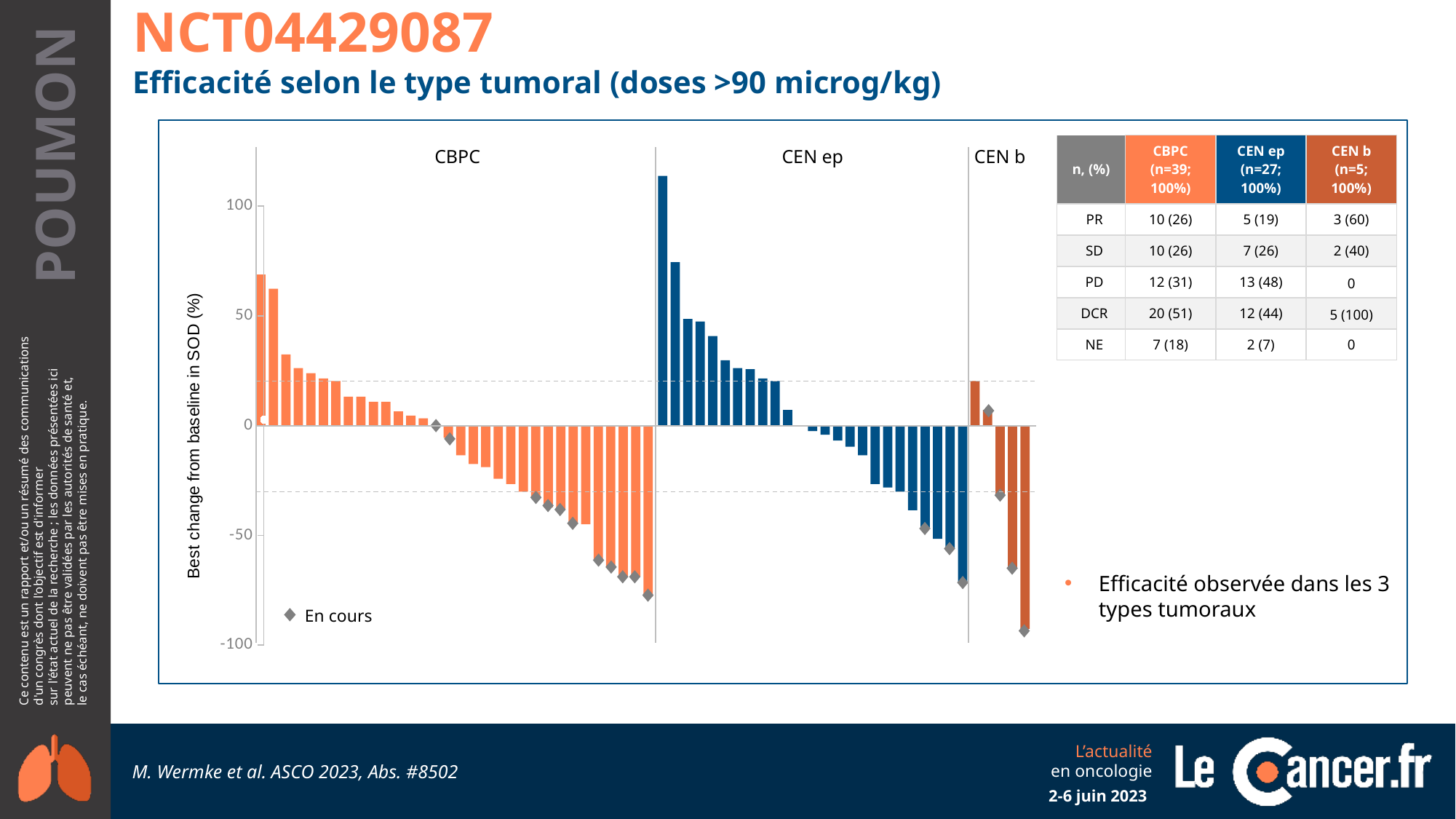
Is the lowest bar in the CBPC group greater or less than -50? less What kind of chart is shown on the slide? bar chart What does the diamond marker in the chart legend represent? En cours Is the tallest bar in the CBPC group greater or less than 50? greater Which tumour type group contains the tallest positive bar in the chart? CEN ep How many tumour type groups are shown in the chart? 3 Is the tallest bar in the CBPC group greater or less than 100? less What is the label of the vertical axis of the chart? Best change from baseline in SOD (%) Within each tumour type group, do the bars rise or fall from left to right? fall Which tumour type group contains the lowest (most negative) bar in the chart? CEN b